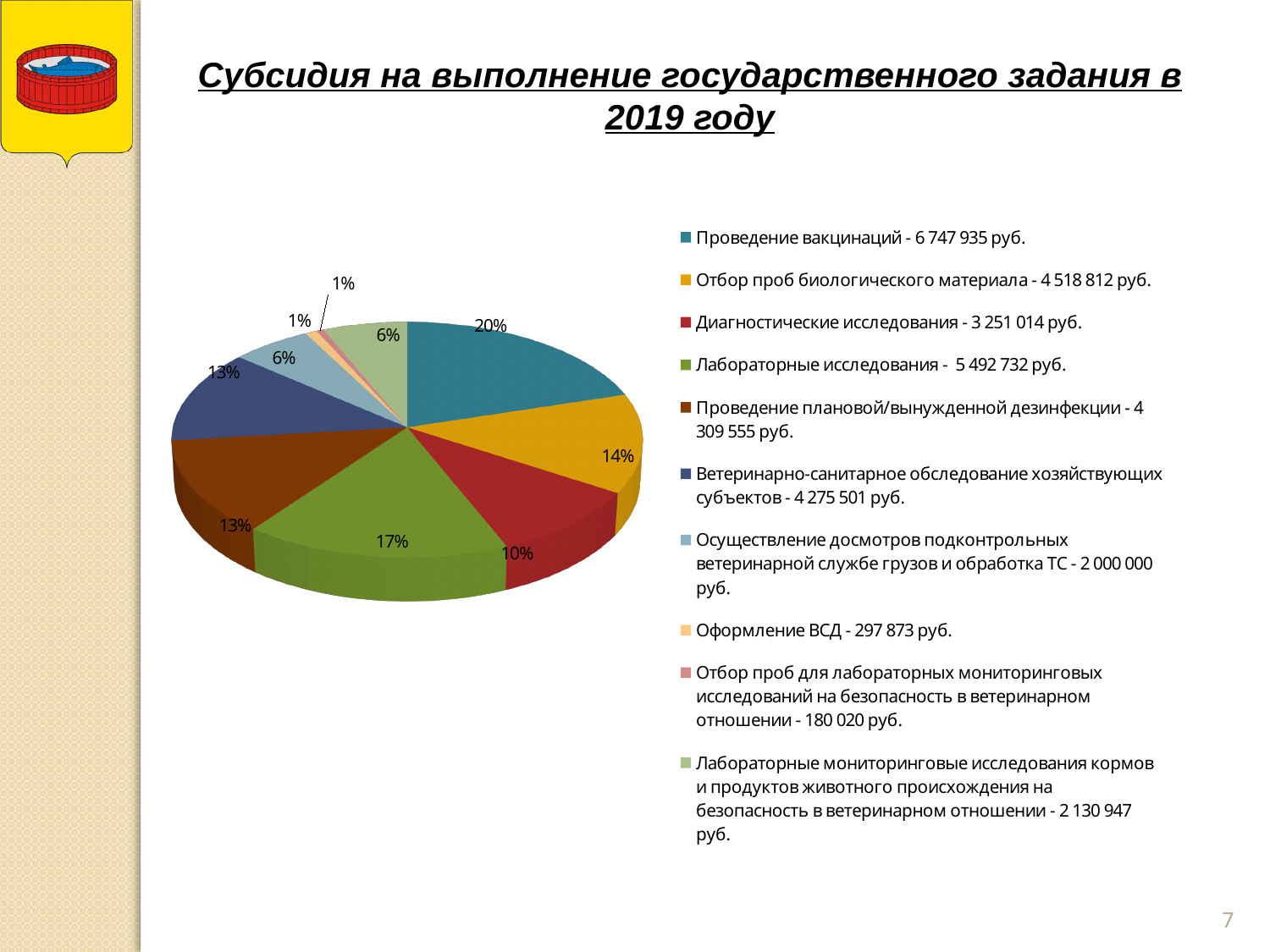
What share of the pie does "Лабораторные исследования" take? 17% What share of the pie does "Проведение вакцинаций" take? 20% According to the legend, what is the amount in rubles for "Проведение плановой/вынужденной дезинфекции"? 4 309 555 руб. Which category has the largest slice of the pie? Проведение вакцинаций What is the difference between the amounts for "Проведение вакцинаций" (6 747 935 руб.) and "Отбор проб биологического материала" (4 518 812 руб.)? 2 229 123 руб. What is the title of the slide containing the pie chart? Субсидия на выполнение государственного задания в 2019 году What share of the pie does "Диагностические исследования" take? 10% According to the legend, what is the amount in rubles for "Оформление ВСД"? 297 873 руб. Which is larger: the amount for "Лабораторные исследования" or for "Отбор проб биологического материала"? Лабораторные исследования How many slices does the pie chart have? 10 What kind of chart is shown on the slide? pie chart